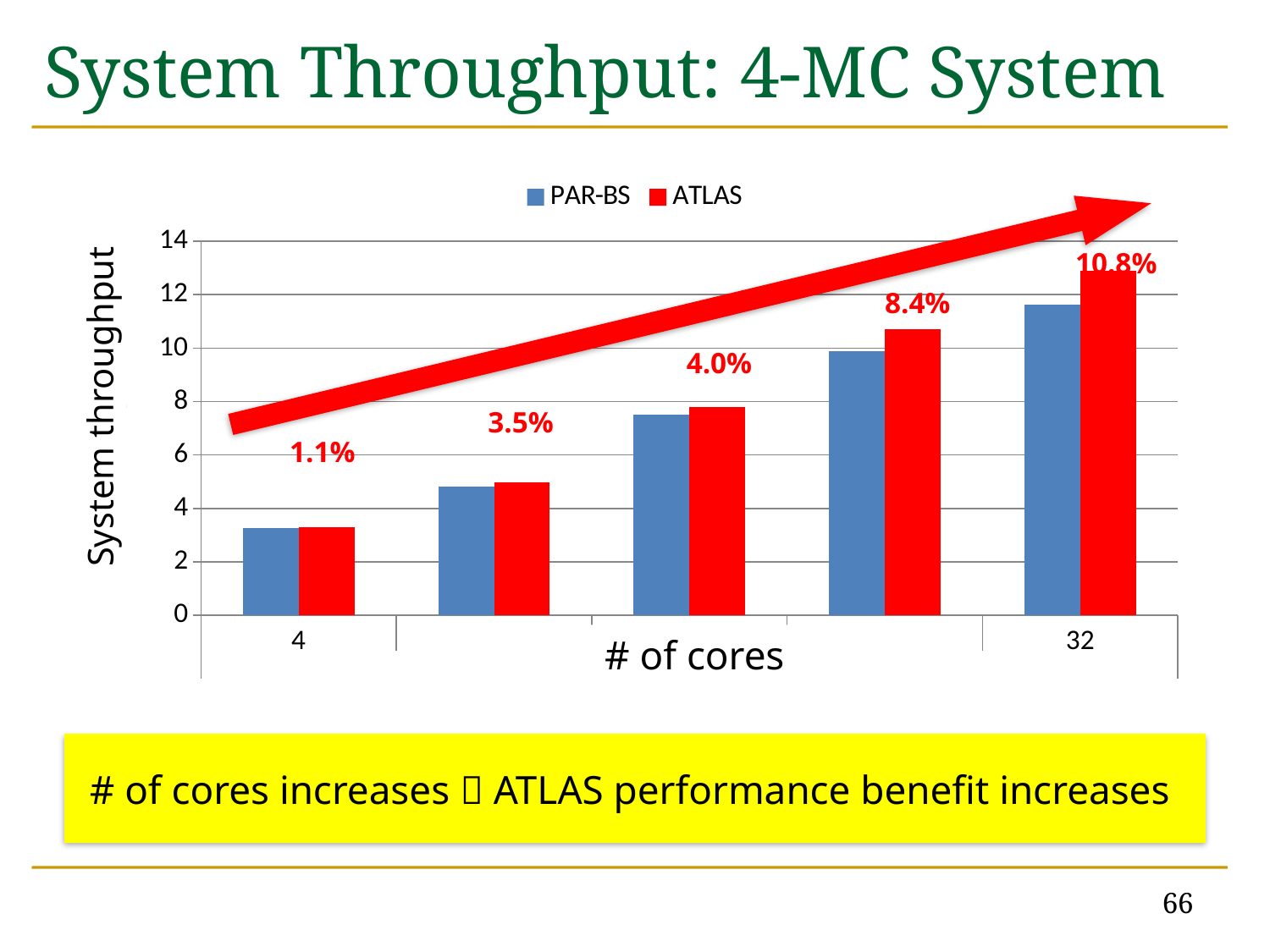
Is the PAR-BS system throughput for 32 cores greater or less than 10? greater Which colour represents the ATLAS series in the legend? red Is the ATLAS system throughput for 32 cores greater or less than 12? greater Which number of cores has the lowest system throughput? 4 Which number of cores has the highest system throughput? 32 Do the system throughput values rise or fall as the number of cores increases? rise How many series does the legend list? 2 How many groups of bars are plotted along the x axis? 5 Is the PAR-BS system throughput for 4 cores greater or less than 4? less What kind of chart is shown on the slide? bar chart What is the title of the slide containing the chart? System Throughput: 4-MC System At 32 cores, which series has the larger system throughput, PAR-BS or ATLAS? ATLAS